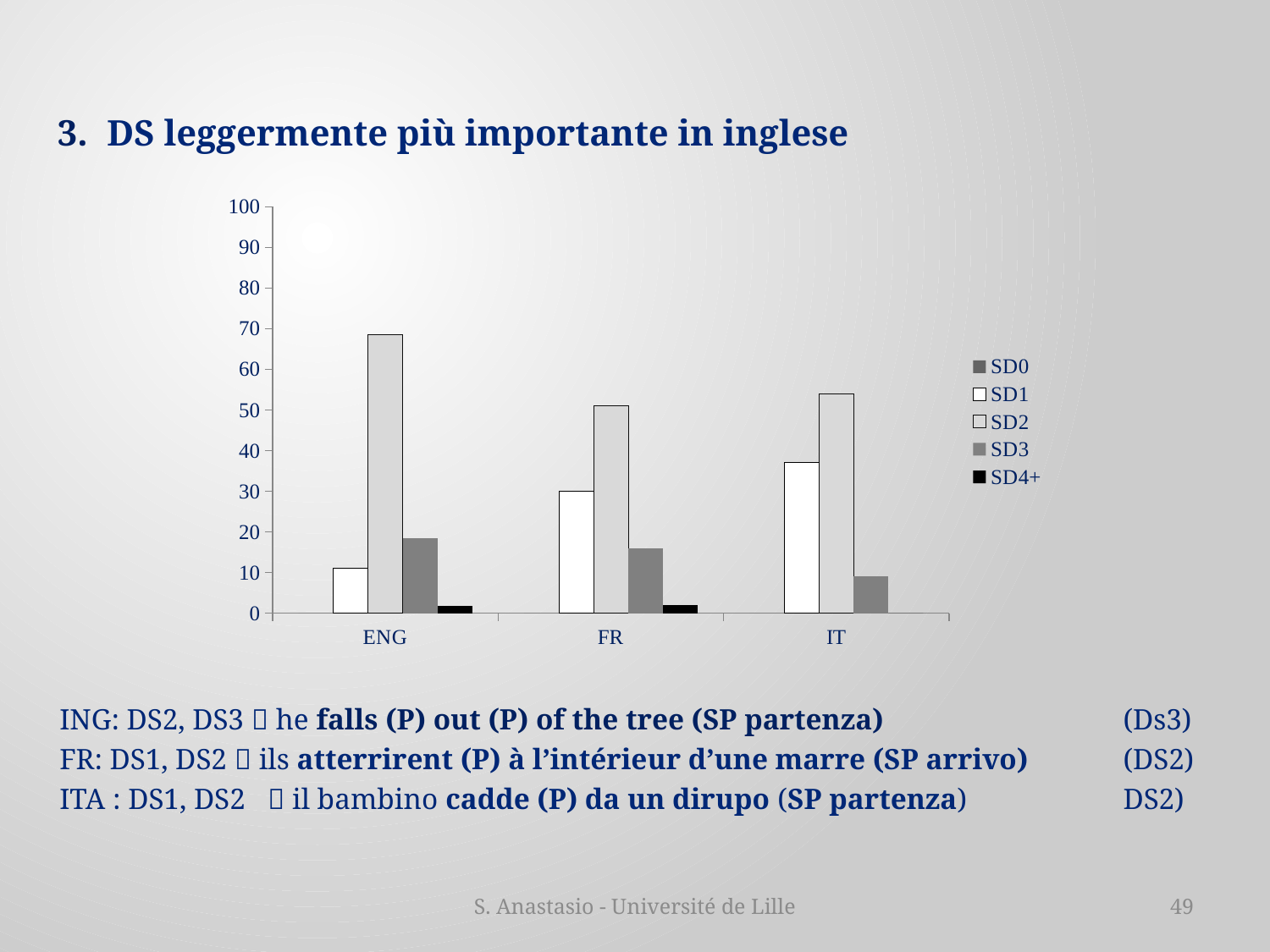
Which category has the highest SD2 value? ENG Which category has the lowest SD3 value? IT Is the SD2 value for ENG greater or less than 60? greater Is the SD2 value for IT greater or less than 50? greater What kind of chart is shown on the slide? bar chart Which category has the lowest SD1 value? ENG How many categories are shown on the x axis of the chart? 3 Which series is shown in black in the chart's legend? SD4+ Is the SD1 value for FR greater or less than 40? less How many series does the chart's legend list? 5 Which is larger, the SD1 value for IT or the SD1 value for FR? IT